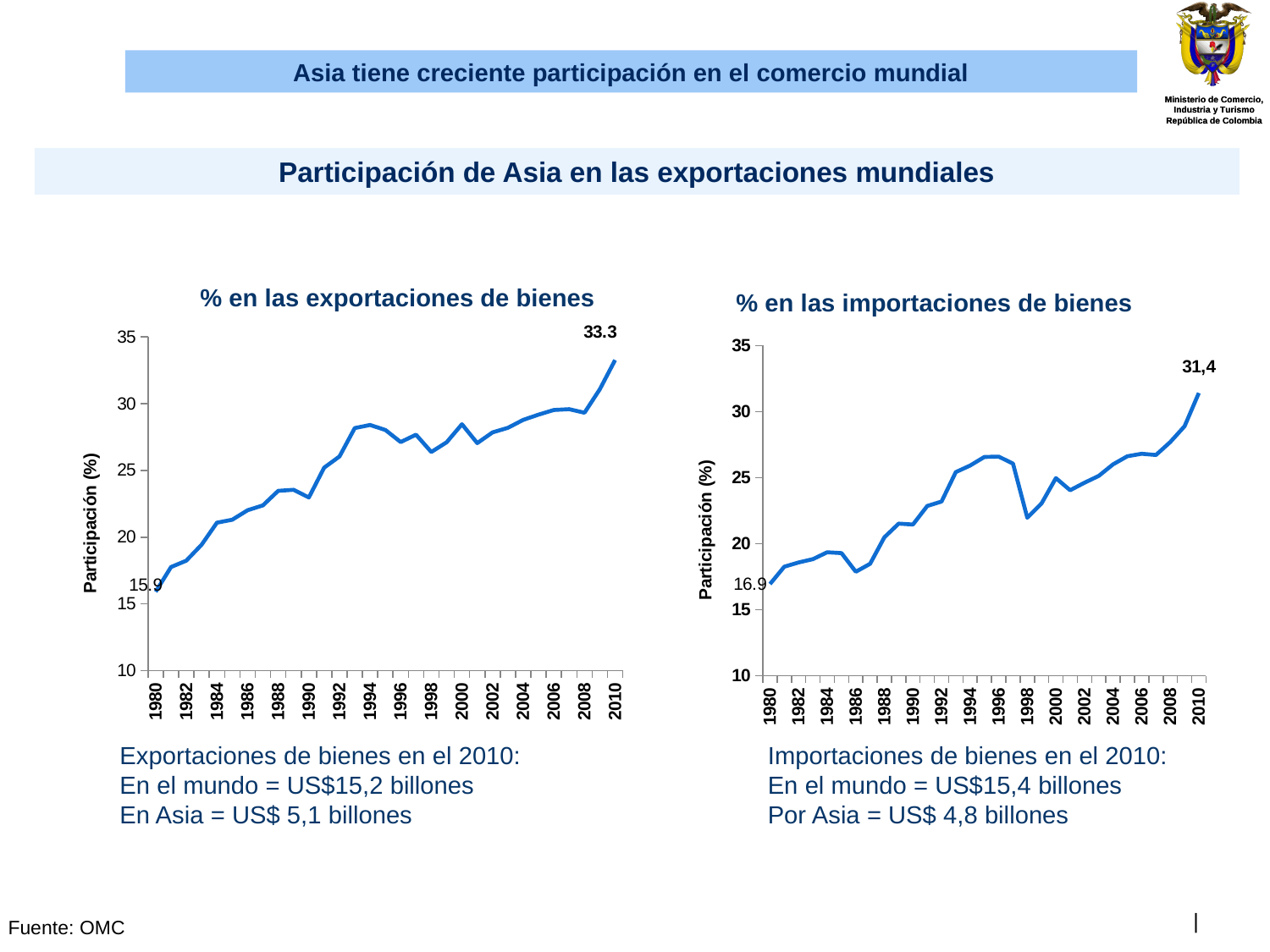
What kind of chart is '% en las exportaciones de bienes'? Line chart In the chart '% en las importaciones de bienes', what is the value for 2010? 31,4 In the chart '% en las exportaciones de bienes', what is the difference between the 2010 value and the 1980 value? 17.4 In the chart '% en las exportaciones de bienes', do the values generally rise or fall from 1980 to 2010? Rise In the chart '% en las importaciones de bienes', is the value for 1998 greater or less than 25? less In the chart '% en las importaciones de bienes', which year has the highest value? 2010 In the chart '% en las exportaciones de bienes', which year has the highest value? 2010 In the chart '% en las importaciones de bienes', what is the difference between the 2010 value and the 1980 value? 14,5 Which is larger: the 2010 value in '% en las exportaciones de bienes' or the 2010 value in '% en las importaciones de bienes'? % en las exportaciones de bienes (33.3) In the chart '% en las exportaciones de bienes', what is the value for 1980? 15.9 In the chart '% en las exportaciones de bienes', what is the value for 2010? 33.3 In the chart '% en las importaciones de bienes', what is the value for 1980? 16.9